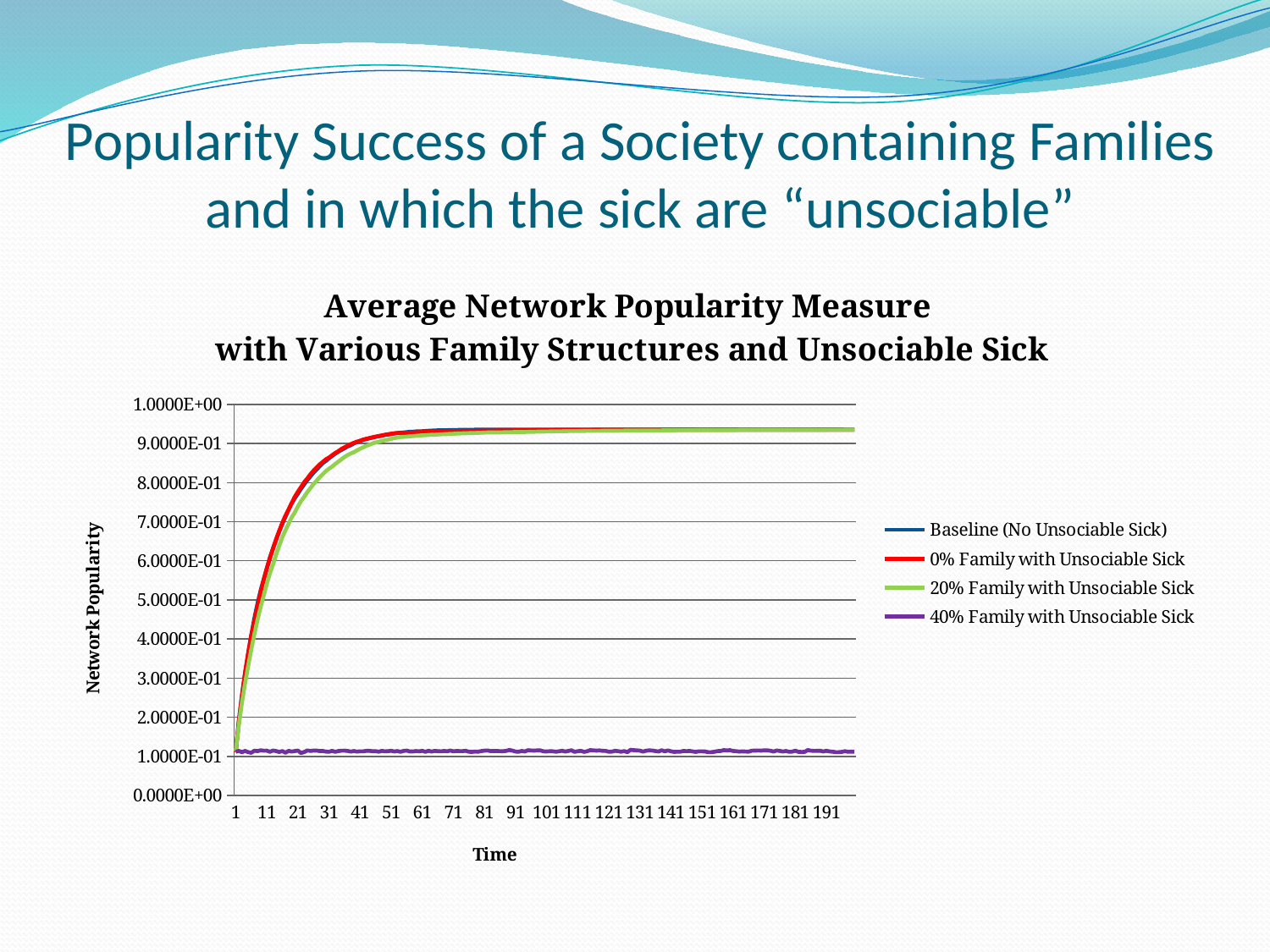
What is the label of the vertical axis? Network Popularity Is the value for 40% Family with Unsociable Sick at time 101 greater or less than 2.0000E-01? less Is the value for 0% Family with Unsociable Sick at time 191 greater or less than 9.0000E-01? greater Which series has the lowest network popularity across the time range? 40% Family with Unsociable Sick What is the title of the chart? Average Network Popularity Measure with Various Family Structures and Unsociable Sick Does the 40% Family with Unsociable Sick series rise, fall, or stay roughly flat as time increases? stay roughly flat Is the value for 20% Family with Unsociable Sick at time 11 greater or less than 7.0000E-01? less Does the Baseline (No Unsociable Sick) series rise or fall as time increases from 1 to 51? rise How many series does the legend list? 4 What kind of chart is shown on the slide? line chart Which is larger at time 151: the value for 0% Family with Unsociable Sick or the value for 40% Family with Unsociable Sick? 0% Family with Unsociable Sick